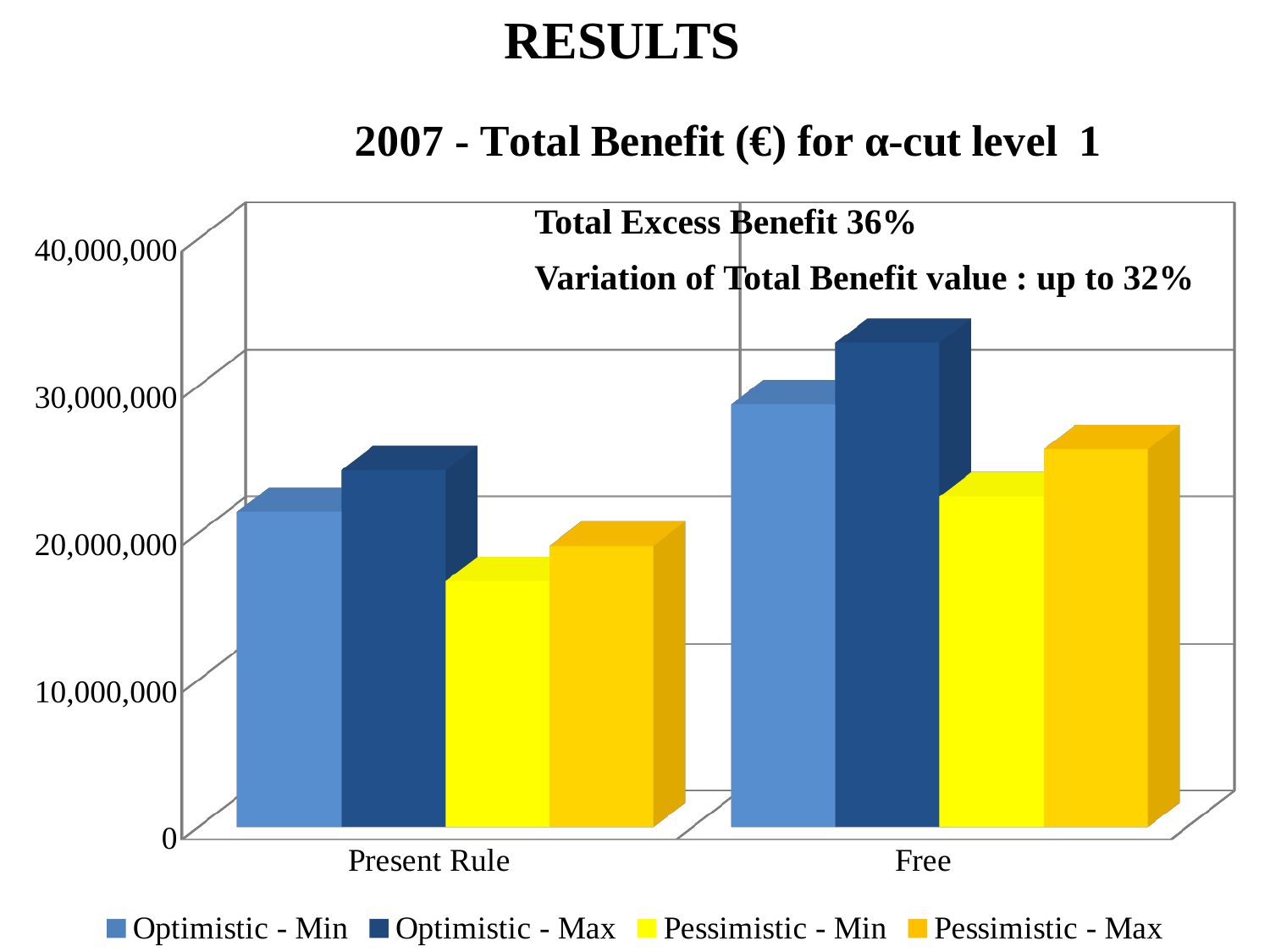
What Total Excess Benefit percentage is stated in the text on the chart? 36% How many categories are shown on the x axis? 2 What kind of chart is shown on the slide? bar chart What is the title of the chart? 2007 - Total Benefit (€) for α-cut level 1 How many series does the legend list? 4 Which series has the tallest bar in the Free category? Optimistic - Max Which series has the shortest bar in the Present Rule category? Pessimistic - Min Is the Pessimistic - Max value for Free greater or less than 30,000,000? less Which category has the larger Optimistic - Max value, Present Rule or Free? Free Is the Pessimistic - Min value for Free greater or less than 20,000,000? greater Is the Optimistic - Max value for Free greater or less than 30,000,000? greater